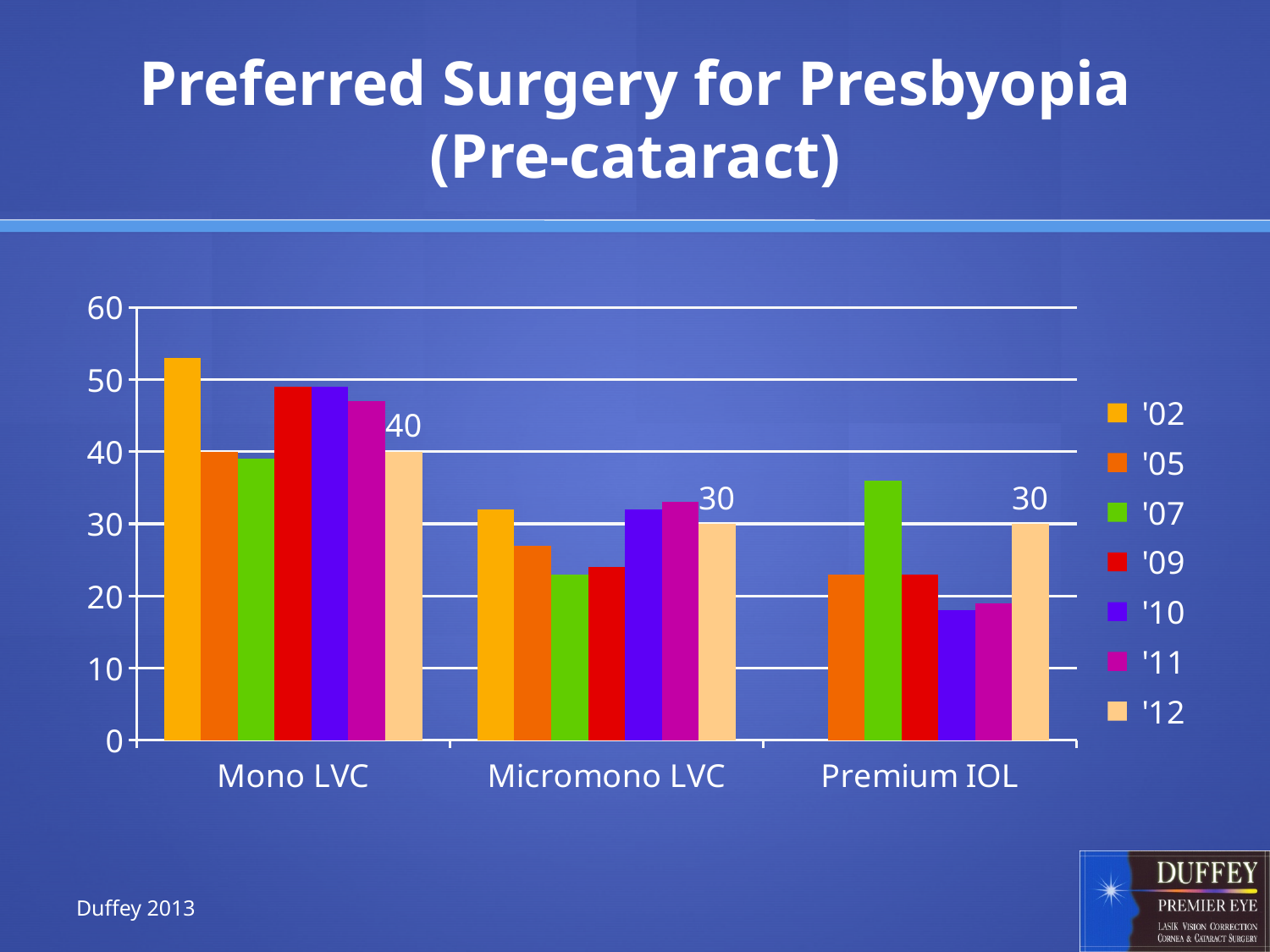
Which is larger: the '05 value for Mono LVC or the '05 value for Premium IOL? Mono LVC What is the value for '12 in the Premium IOL category? 30 What is the value for '12 in the Mono LVC category? 40 Is the value for '10 in the Premium IOL category greater or less than 20? less How many categories are shown on the x axis? 3 What kind of chart is shown on the slide? Bar chart Which category has the highest '12 value? Mono LVC How many series does the legend list? 7 Is the value for '07 in the Premium IOL category greater or less than 30? greater What is the value for '12 in the Micromono LVC category? 30 What is the difference between the '12 values for Mono LVC and Micromono LVC? 10 Is the value for '02 in the Mono LVC category greater or less than 50? greater